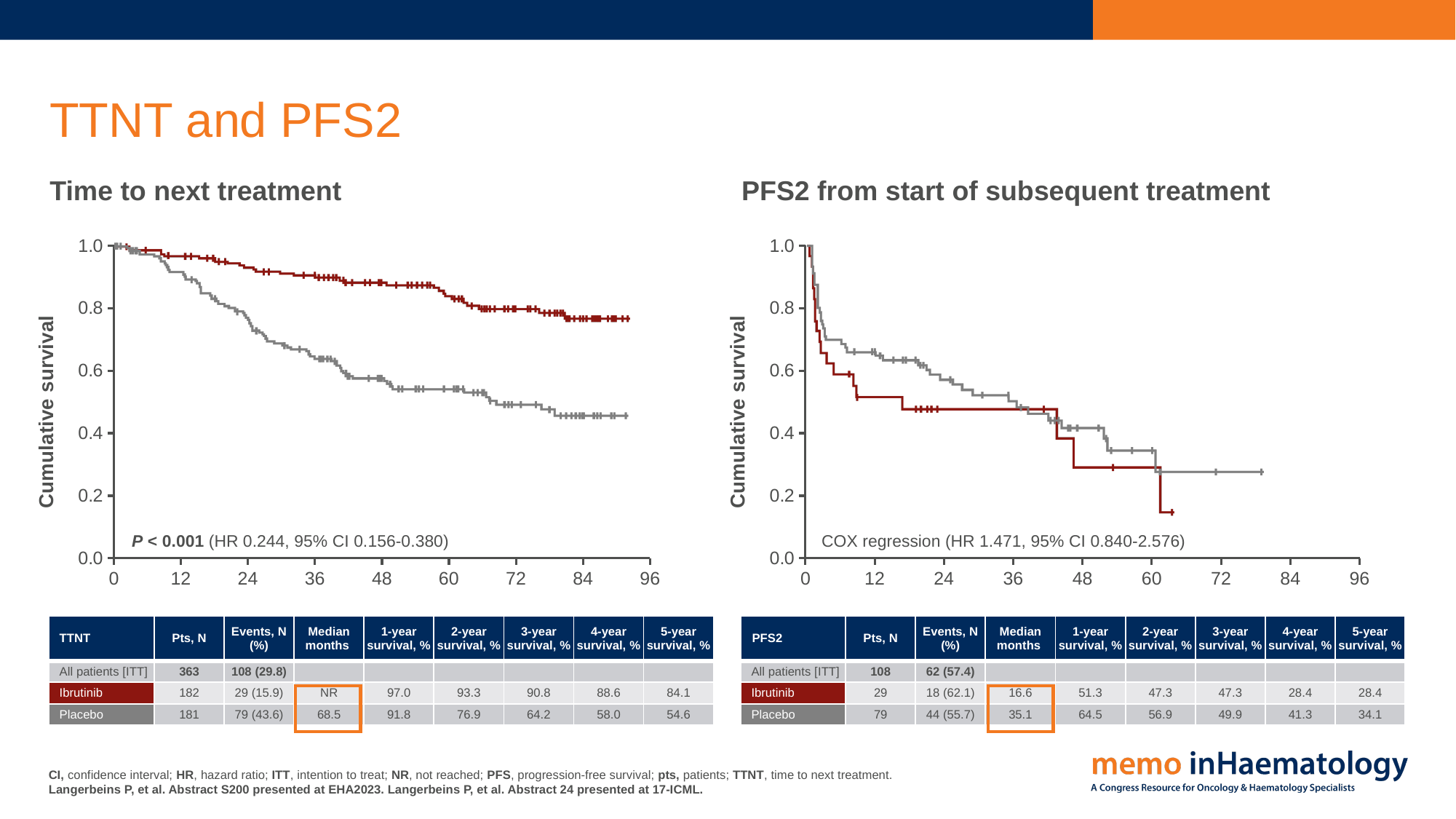
On the 'PFS2 from start of subsequent treatment' chart, which curve is higher at 12 months, the red (Ibrutinib) or the grey (Placebo)? grey (Placebo) What is the difference in median PFS2 months between Placebo (35.1) and Ibrutinib (16.6)? 18.5 What hazard ratio is printed on the 'Time to next treatment' chart? 0.244 What is the median time to next treatment in months for Placebo, as shown in the TTNT table? 68.5 On the 'PFS2 from start of subsequent treatment' chart, is the final value of the red (Ibrutinib) curve greater or less than 0.2? less On the 'Time to next treatment' chart, is the grey (Placebo) curve at 60 months greater or less than 0.6? less On the 'PFS2 from start of subsequent treatment' chart, is the red (Ibrutinib) curve at 24 months greater or less than 0.6? less On the 'Time to next treatment' chart, which curve is higher at 60 months, the red (Ibrutinib) or the grey (Placebo)? red (Ibrutinib) In the 'Time to next treatment' chart, do the curves rise or fall as time increases along the x axis? fall How many curves are plotted on the 'PFS2 from start of subsequent treatment' chart? 2 What kind of chart is the 'Time to next treatment' chart? line chart